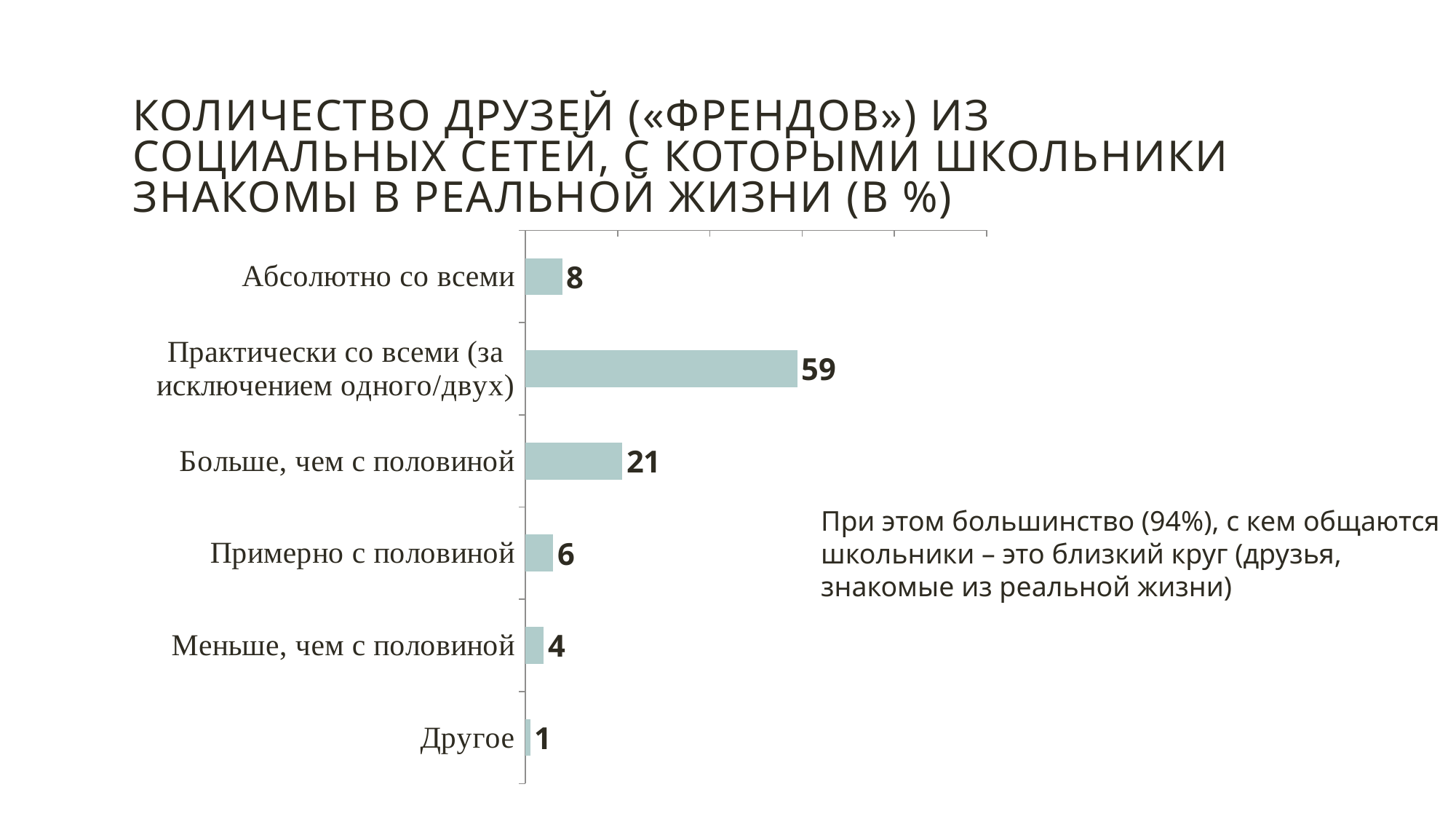
What is the value for «Меньше, чем с половиной»? 4 Which category has the highest value? Практически со всеми (за исключением одного/двух) How many categories are shown in the chart? 6 What is the value for «Практически со всеми (за исключением одного/двух)»? 59 What is the difference between the values for «Практически со всеми (за исключением одного/двух)» and «Больше, чем с половиной»? 38 What is the difference between the values for «Меньше, чем с половиной» and «Другое»? 3 What is the value for «Примерно с половиной»? 6 Which is larger: the value for «Абсолютно со всеми» or the value for «Примерно с половиной»? Абсолютно со всеми Which category has the lowest value? Другое What kind of chart is shown on the slide? Bar chart What is the value for «Больше, чем с половиной»? 21 What is the value for «Абсолютно со всеми»? 8